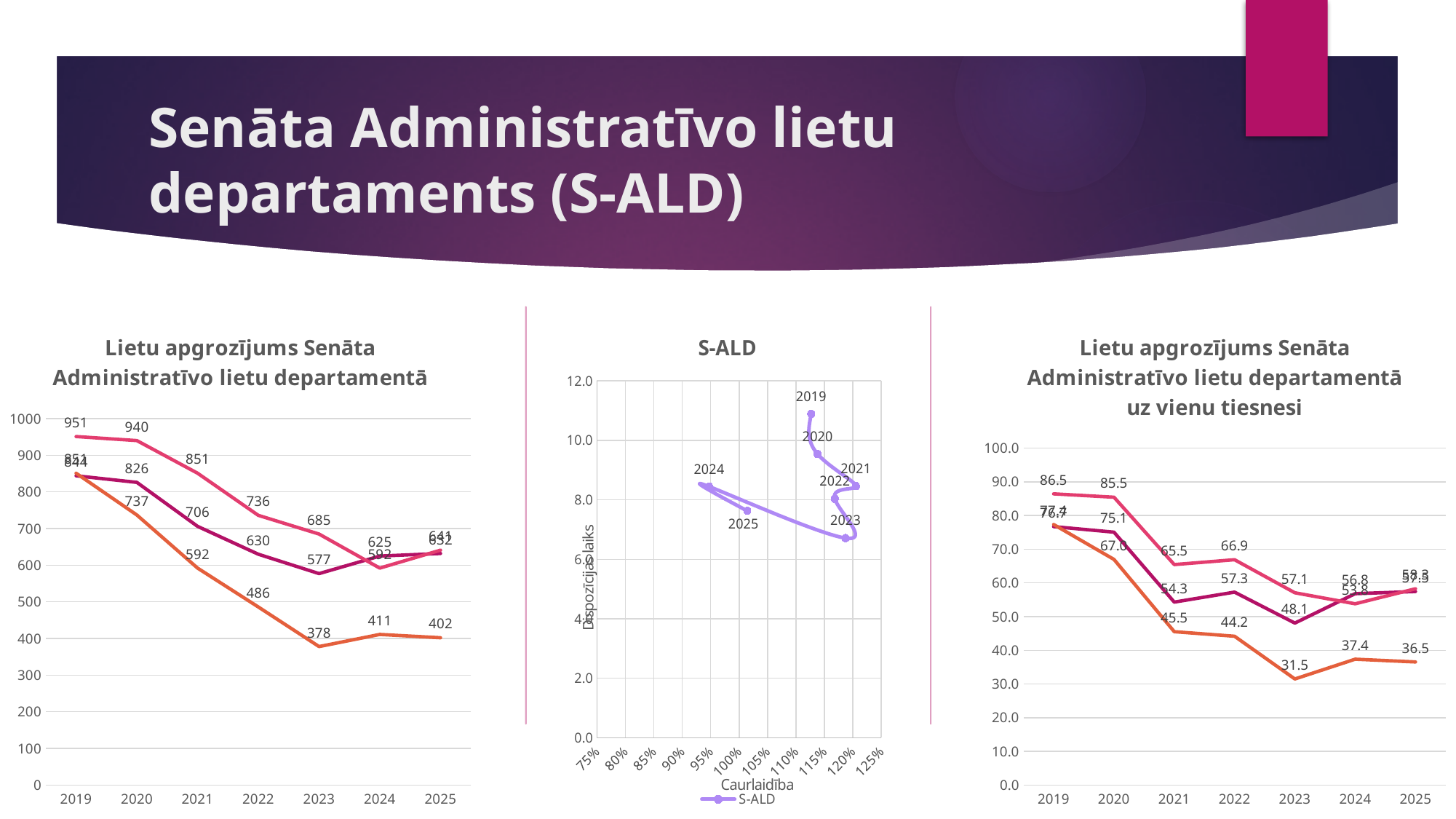
In the middle chart 'S-ALD', is the Dispozīcijas laiks value for 2023 greater or less than 8.0? less In the left chart 'Lietu apgrozījums Senāta Administratīvo lietu departamentā', what is the value of the top pink line in 2020? 940 In the left chart 'Lietu apgrozījums Senāta Administratīvo lietu departamentā', what is the difference between the pink line (851) and the orange line (592) in 2021? 259 In the middle chart 'S-ALD', what is the label of the x axis? Caurlaidība In the left chart 'Lietu apgrozījums Senāta Administratīvo lietu departamentā', what is the value of the orange line in 2023? 378 What type of chart is the middle chart titled 'S-ALD'? scatter chart In the right chart 'Lietu apgrozījums Senāta Administratīvo lietu departamentā uz vienu tiesnesi', which is larger in 2022: the pink line (66.9) or the orange line (44.2)? pink line (66.9) In the right chart 'Lietu apgrozījums Senāta Administratīvo lietu departamentā uz vienu tiesnesi', does the orange line generally rise or fall from 2019 to 2023? fall In the left chart 'Lietu apgrozījums Senāta Administratīvo lietu departamentā', in which year is the orange line at its lowest? 2023 In the right chart 'Lietu apgrozījums Senāta Administratīvo lietu departamentā uz vienu tiesnesi', what is the value of the orange line in 2023? 31.5 In the middle chart 'S-ALD', is the Dispozīcijas laiks value for 2019 greater or less than 10.0? greater In the left chart 'Lietu apgrozījums Senāta Administratīvo lietu departamentā', how many years are shown on the x axis? 7